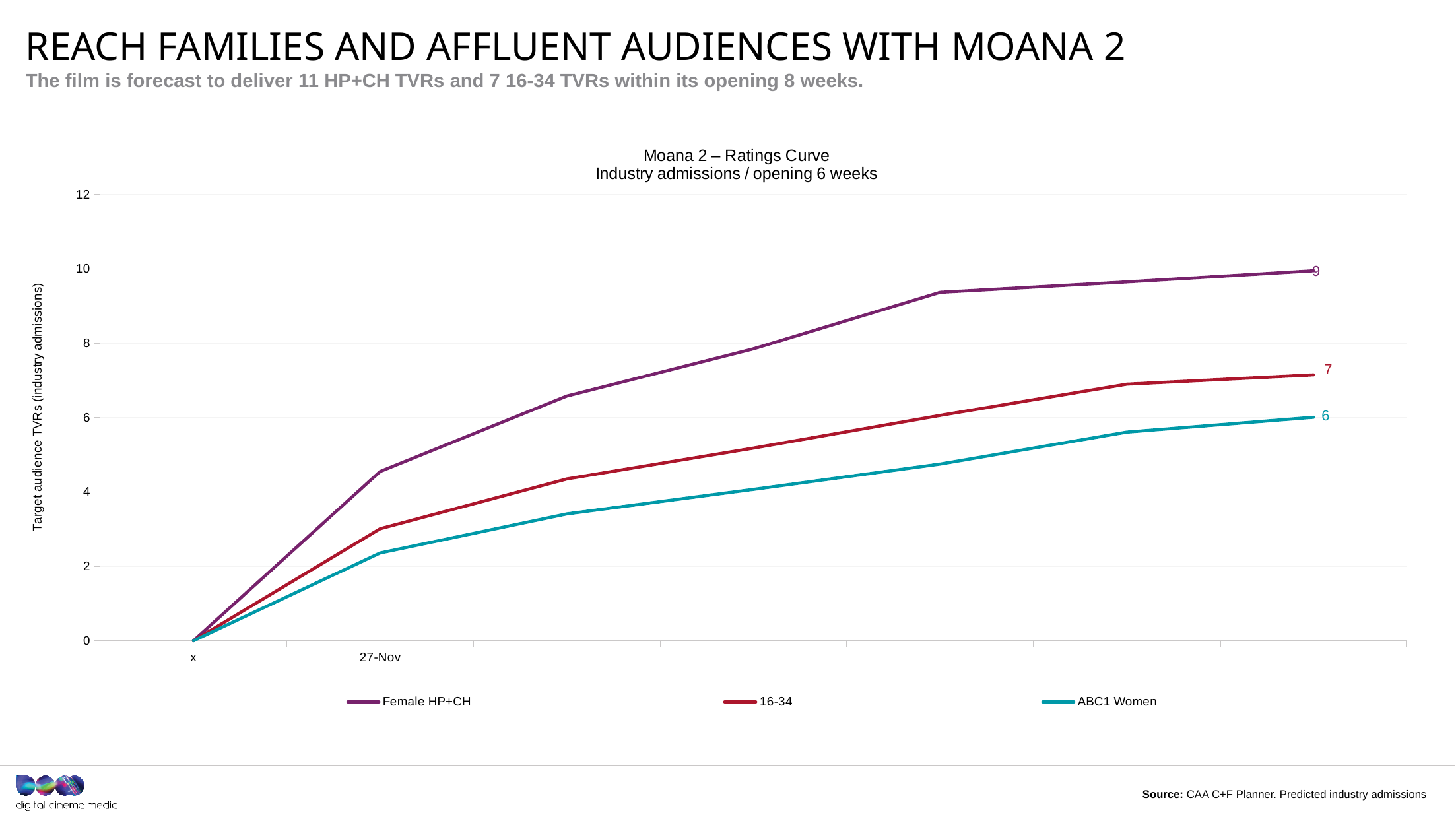
Do the values of the Female HP+CH series rise or fall along the x axis? rise What is the final labelled value for the ABC1 Women series? 6 What kind of chart is shown on the slide? line chart What is the title of the chart? Moana 2 – Ratings Curve What is the final labelled value for the Female HP+CH series? 9 Which series has the lowest value at the end of the curve? ABC1 Women Is the value for the 16-34 series at 27-Nov greater or less than 4? less Which series reaches the highest value at the end of the curve? Female HP+CH How many series does the legend list? 3 What is the final labelled value for the 16-34 series? 7 Which series has the larger final value, 16-34 or ABC1 Women? 16-34